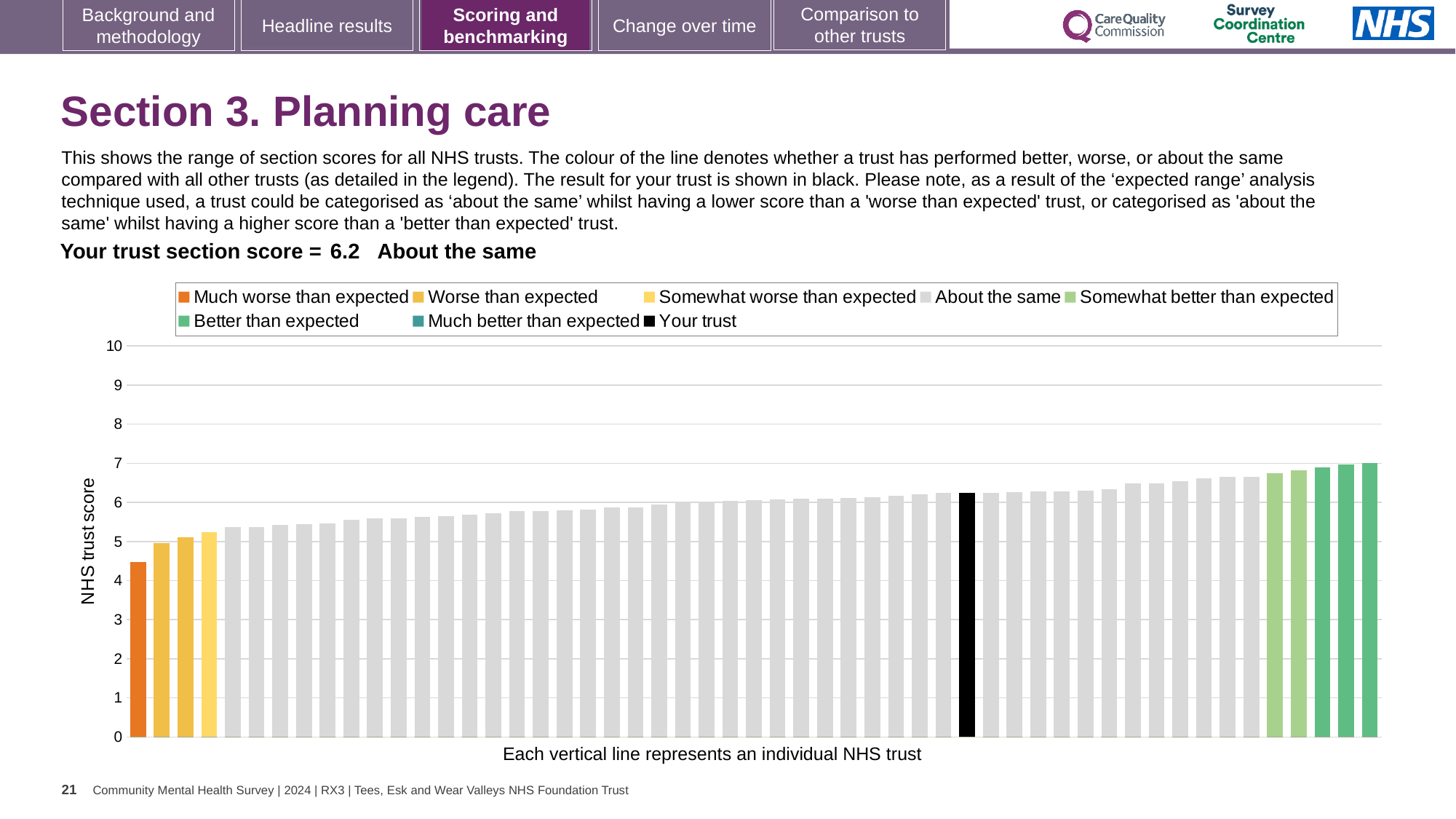
Is the value of the tallest bar greater or less than 8? less How many entries does the chart legend list? 8 What is the section score for your trust shown on the slide? 6.2 What is the label on the vertical axis of the chart? NHS trust score What kind of chart is shown on the slide? bar chart How many bars are coloured orange for 'Much worse than expected'? 1 Do the bar values rise or fall from left to right along the x axis? rise Which legend category does the lowest bar belong to? Much worse than expected Is the value of the lowest bar (the orange bar) greater or less than 5? less What colour is used for the 'Your trust' bar in the chart? black Which performance category is your trust placed in according to the slide? About the same Is the value of the black bar for your trust greater or less than 6? greater